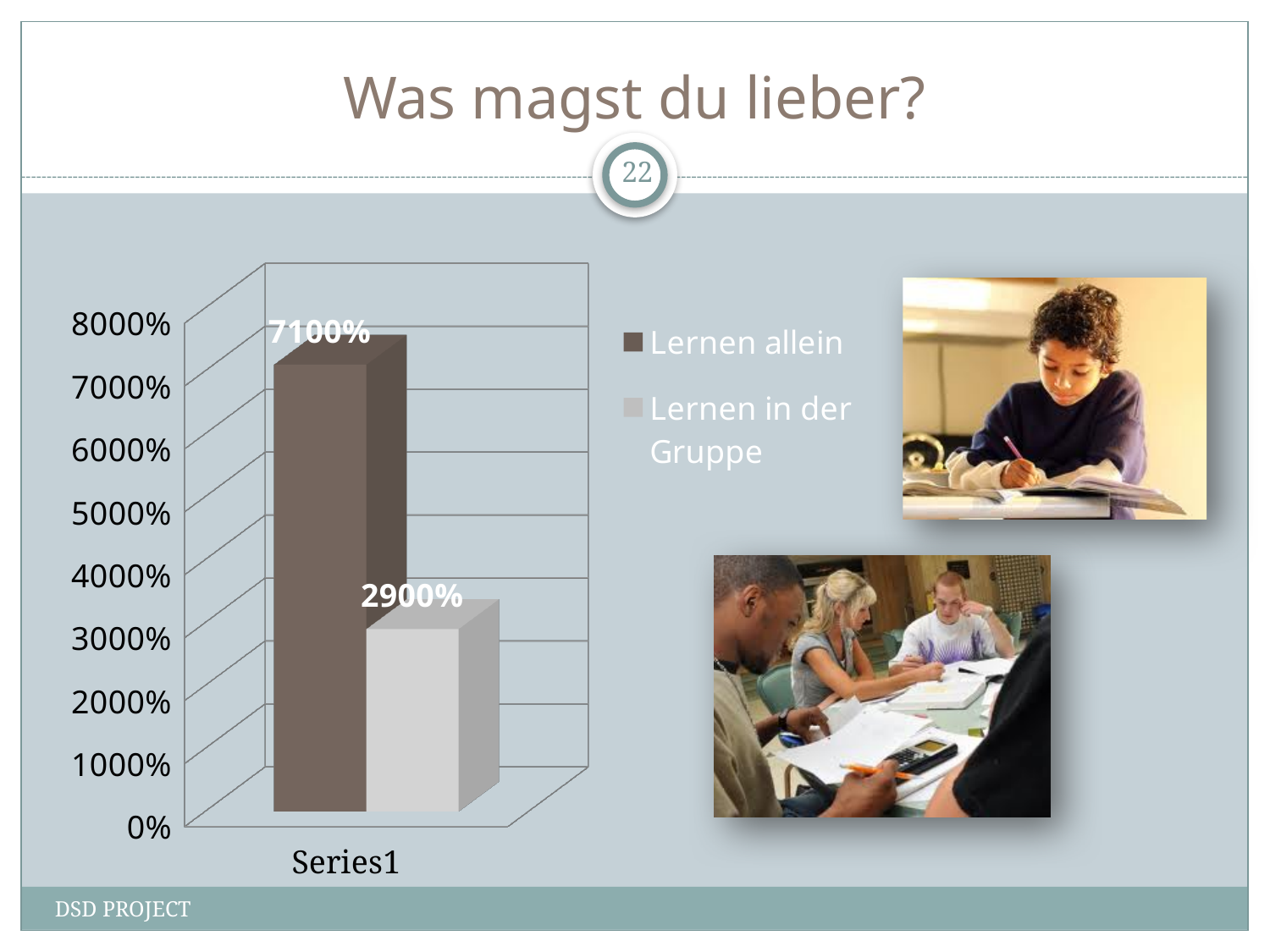
Which series has the lowest value? Lernen in der Gruppe What is the value for Lernen in der Gruppe? 2900% Which is larger, the value for Lernen allein or the value for Lernen in der Gruppe? Lernen allein What is the difference between the values for Lernen allein and Lernen in der Gruppe? 4200% What kind of chart is shown on the slide? bar chart Which series has the highest value? Lernen allein Is the value for Lernen allein greater or less than 6000%? greater How many series does the legend list? 2 What is the title of the slide containing the chart? Was magst du lieber? Is the value for Lernen in der Gruppe greater or less than 4000%? less What is the value for Lernen allein? 7100% What is the category label shown on the x axis? Series1